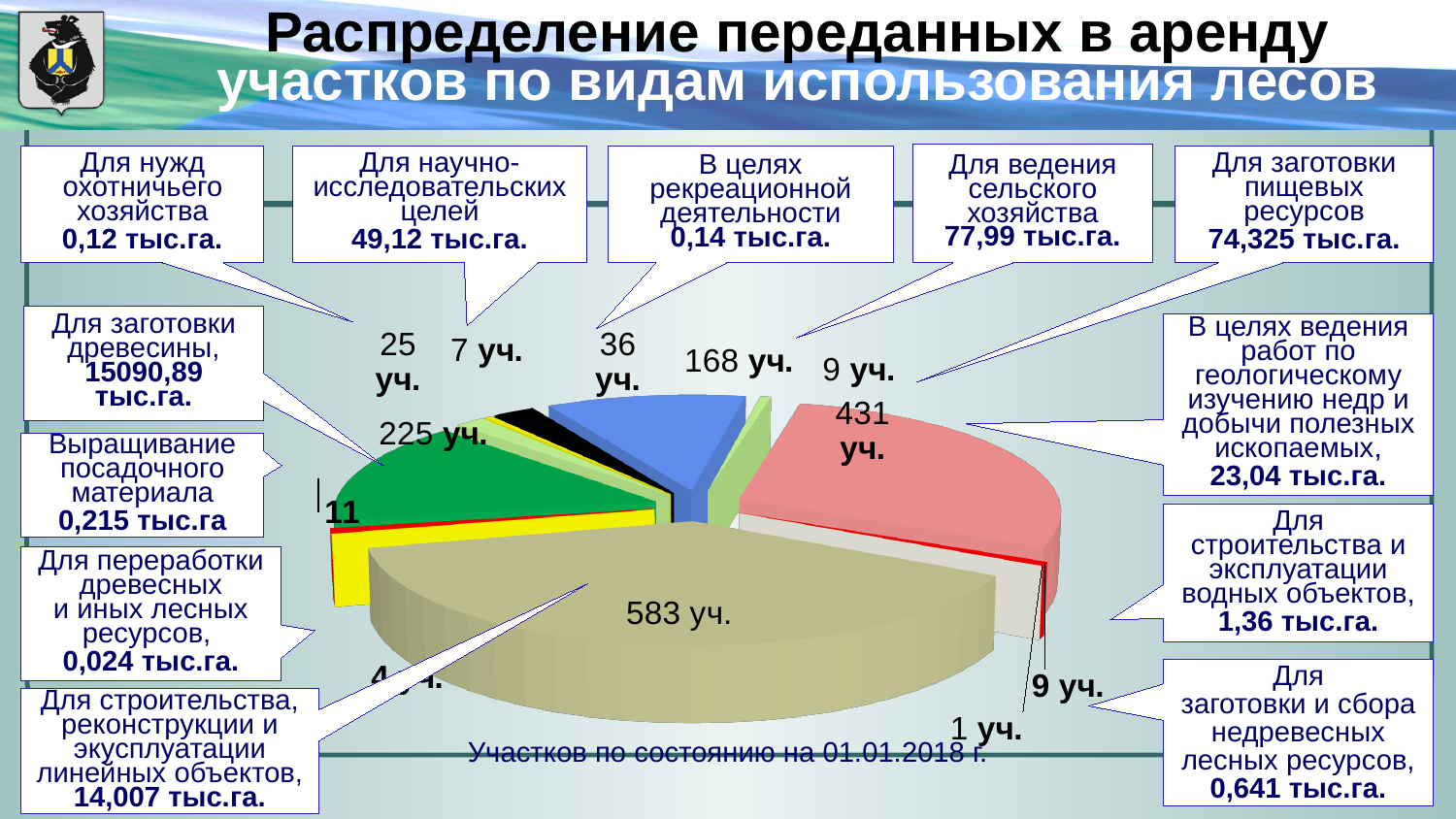
What is the difference in area between 'Для ведения сельского хозяйства' (77,99 тыс.га.) and 'Для заготовки пищевых ресурсов' (74,325 тыс.га.)? 3,665 тыс.га. What area is given for 'Для заготовки древесины'? 15090,89 тыс.га. How many forest-use categories are shown around the pie chart? 12 What area is given for 'Для переработки древесных и иных лесных ресурсов'? 0,024 тыс.га. What type of chart is shown on the slide? pie chart What area is given for 'Для ведения сельского хозяйства'? 77,99 тыс.га. What area is given for 'Для строительства и эксплуатации водных объектов'? 1,36 тыс.га. What number of plots is labelled on the largest slice of the pie? 583 уч. What is the smallest number of plots labelled on any slice of the pie? 1 уч. Which has the larger area: 'Для ведения сельского хозяйства' or 'Для заготовки пищевых ресурсов'? Для ведения сельского хозяйства What area is given for 'Для научно-исследовательских целей'? 49,12 тыс.га. As of what date are the plot counts given, according to the note under the chart? 01.01.2018 г.